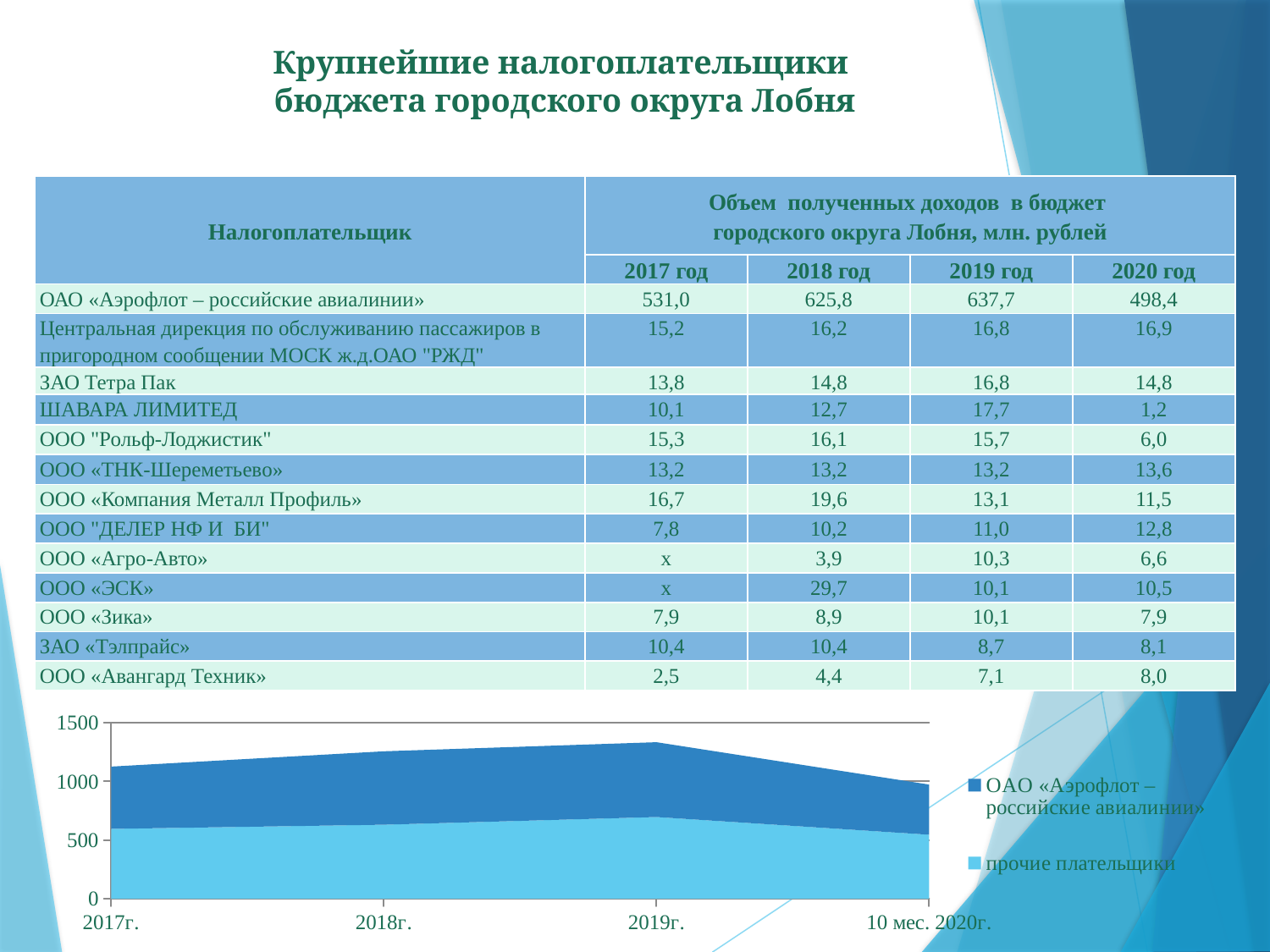
Is the combined total of both series in 2019г. greater or less than 1000? greater Is the combined total of both series in 2017г. greater or less than 1000? greater Which series is shown in the darker blue in the chart? ОАО «Аэрофлот – российские авиалинии» How many series does the legend of the chart list? 2 What is the label of the last period on the x axis of the chart? 10 мес. 2020г. In which period is the combined total of both series lowest in the chart? 10 мес. 2020г. How many periods are plotted along the x axis of the chart? 4 In which period is the combined total of both series highest in the chart? 2019г. What kind of chart is shown at the bottom of the slide? area chart How does the combined total of both series change from 2017г. to 2019г. in the chart? it rises Which period has the larger combined total in the chart, 2018г. or 10 мес. 2020г.? 2018г. Is the value for прочие плательщики in 2019г. greater or less than 500? greater